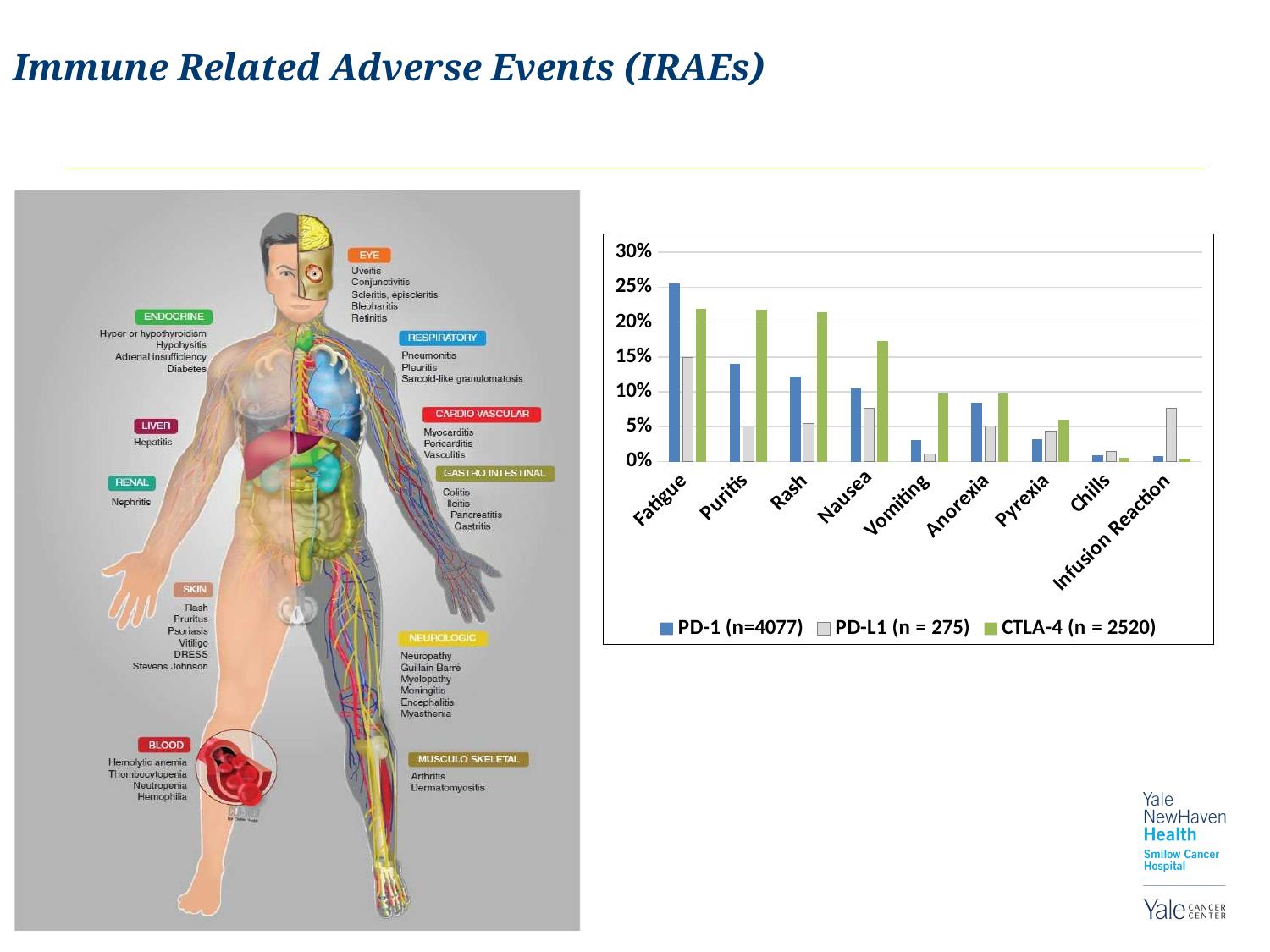
In the bar chart, which category has the highest PD-1 value? Fatigue In the bar chart, which category has the highest PD-L1 value? Fatigue For Fatigue, which is larger: the PD-1 value or the CTLA-4 value? PD-1 Is the PD-1 value for Vomiting greater or less than 5%? less How many adverse event categories are shown on the x axis of the bar chart? 9 Is the PD-1 value for Fatigue greater or less than 20%? greater Is the CTLA-4 value for Nausea greater or less than 15%? greater How many series does the legend of the bar chart list? 3 For Nausea, which is larger: the PD-1 value or the CTLA-4 value? CTLA-4 What kind of chart is shown on the right side of the slide? bar chart Which series in the bar chart has the largest sample size according to the legend? PD-1 (n=4077)